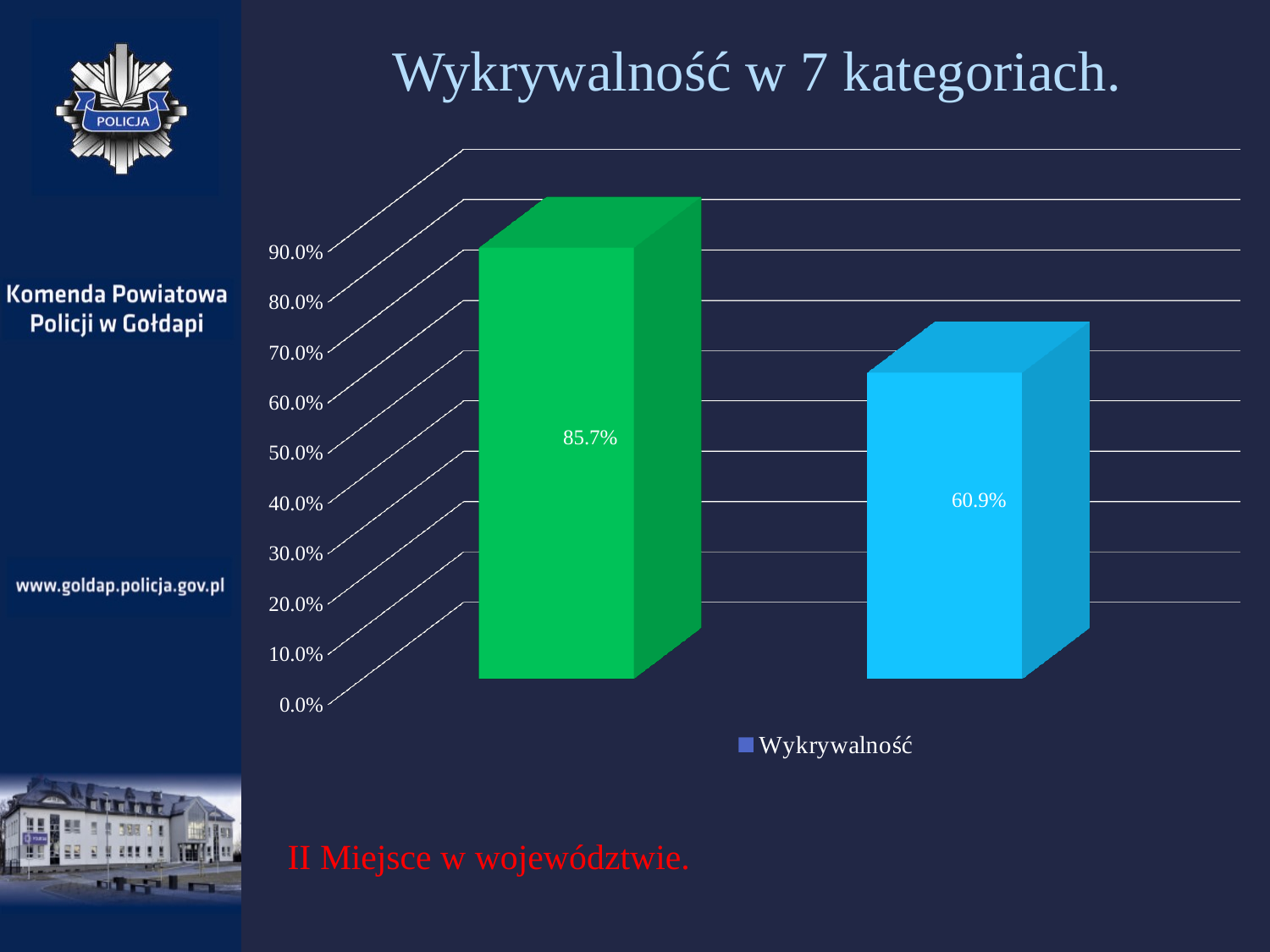
What is the title of the chart? Wykrywalność w 7 kategoriach. Which bar has the higher value, the green (left) bar or the blue (right) bar? the green (left) bar What is the value shown on the blue bar (right) in the chart? 60.9% Is the value of the green (left) bar greater or less than 80.0%? greater Is the value of the blue (right) bar greater or less than 70.0%? less How many bars are plotted in the chart? 2 What kind of chart is shown on the slide? bar chart What is the difference between the value of the green bar and the value of the blue bar? 24.8% Which bar has the lower value, the green (left) bar or the blue (right) bar? the blue (right) bar What is the value shown on the green bar (left) in the chart? 85.7% How many series does the legend list? 1 Is the value of the blue (right) bar larger or smaller than the value of the green (left) bar? smaller